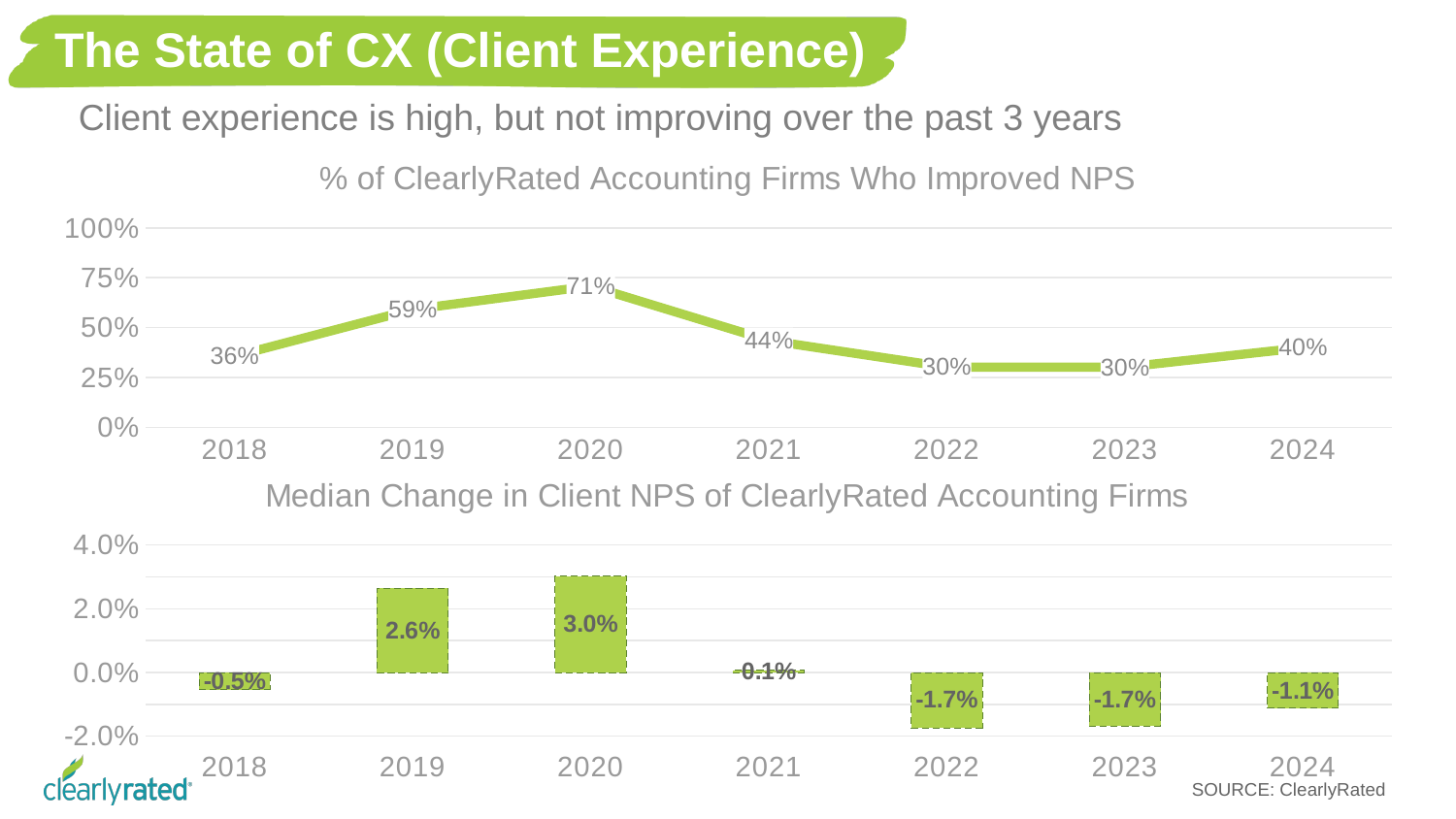
What kind of chart is the top chart, '% of ClearlyRated Accounting Firms Who Improved NPS'? Line chart In the chart titled '% of ClearlyRated Accounting Firms Who Improved NPS', which year has the highest value? 2020 In the chart titled '% of ClearlyRated Accounting Firms Who Improved NPS', what is the value for 2024? 40% What kind of chart is the bottom chart, 'Median Change in Client NPS of ClearlyRated Accounting Firms'? Bar chart In the chart titled '% of ClearlyRated Accounting Firms Who Improved NPS', what is the difference between the 2019 and 2018 values? 23% In the chart titled 'Median Change in Client NPS of ClearlyRated Accounting Firms', what is the value for 2024? -1.1% In the chart titled 'Median Change in Client NPS of ClearlyRated Accounting Firms', which year has the highest value? 2020 In the chart titled '% of ClearlyRated Accounting Firms Who Improved NPS', what is the value for 2020? 71% In the chart titled '% of ClearlyRated Accounting Firms Who Improved NPS', how many years are plotted? 7 In the chart titled '% of ClearlyRated Accounting Firms Who Improved NPS', do the values rise or fall from 2020 to 2022? Fall In the chart titled 'Median Change in Client NPS of ClearlyRated Accounting Firms', which is larger, the value for 2018 or the value for 2022? 2018 In the chart titled 'Median Change in Client NPS of ClearlyRated Accounting Firms', what is the value for 2019? 2.6%